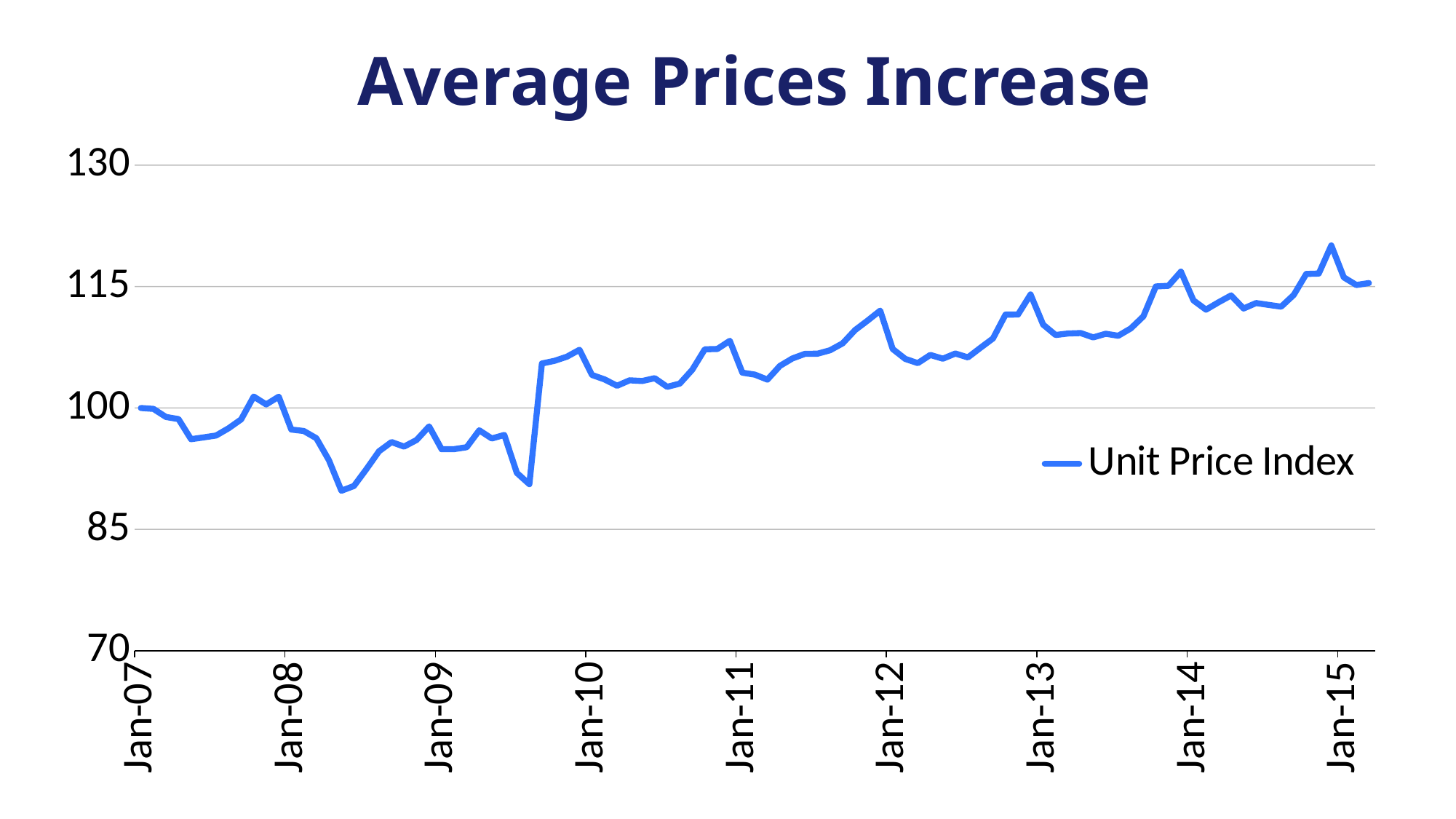
Is the value of the Unit Price Index at Jan-08 greater or less than 100? less What is the name of the series shown in the legend? Unit Price Index What is the title of the chart? Average Prices Increase Which is larger, the Unit Price Index at Jan-10 or at Jan-08? Jan-10 Is the value of the Unit Price Index at Jan-12 greater or less than 115? less Is the value of the Unit Price Index at Jan-09 greater or less than 100? less How many series does the legend list? 1 What kind of chart is shown on the slide? line chart Overall, does the Unit Price Index rise or fall from Jan-07 to Jan-15? rise What is the value of the Unit Price Index at Jan-07? 100 How many year labels are shown on the x axis? 9